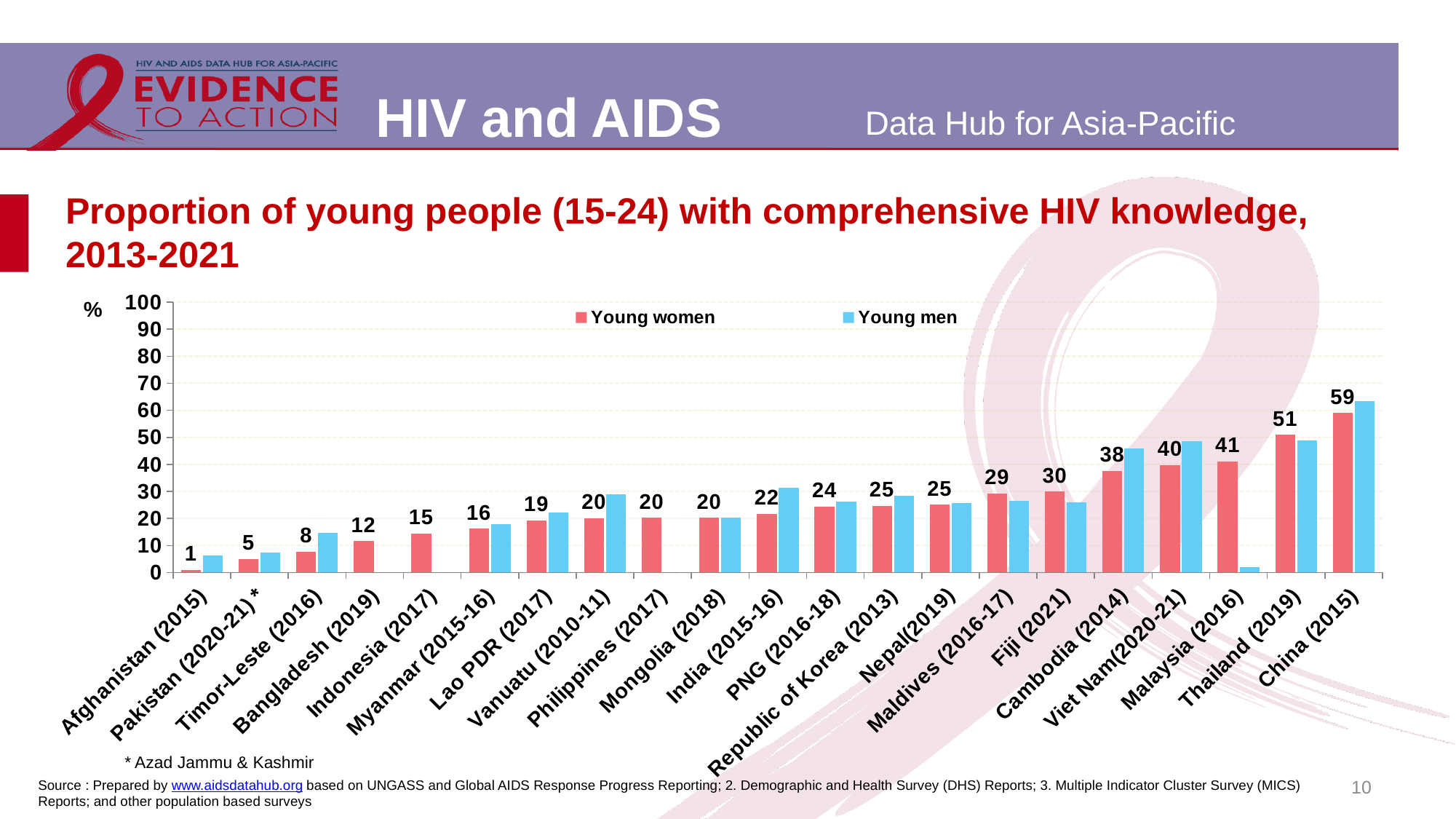
What is the difference between the Young women values for China (2015) and Afghanistan (2015)? 58 Which country has the highest value for Young women? China (2015) Which country has the lowest value for Young women? Afghanistan (2015) How many series does the legend list? 2 What is the value for Young women in Thailand (2019)? 51 Do the Young women values rise or fall from left to right along the x axis? rise Which has a larger Young women value, Cambodia (2014) or Fiji (2021)? Cambodia (2014) What is the value for Young women in Bangladesh (2019)? 12 Is the value for Young men in China (2015) greater or less than 60? greater How many countries are shown on the x axis of the chart? 21 What kind of chart is shown on the slide? bar chart Is the value for Young men in Malaysia (2016) greater or less than 10? less